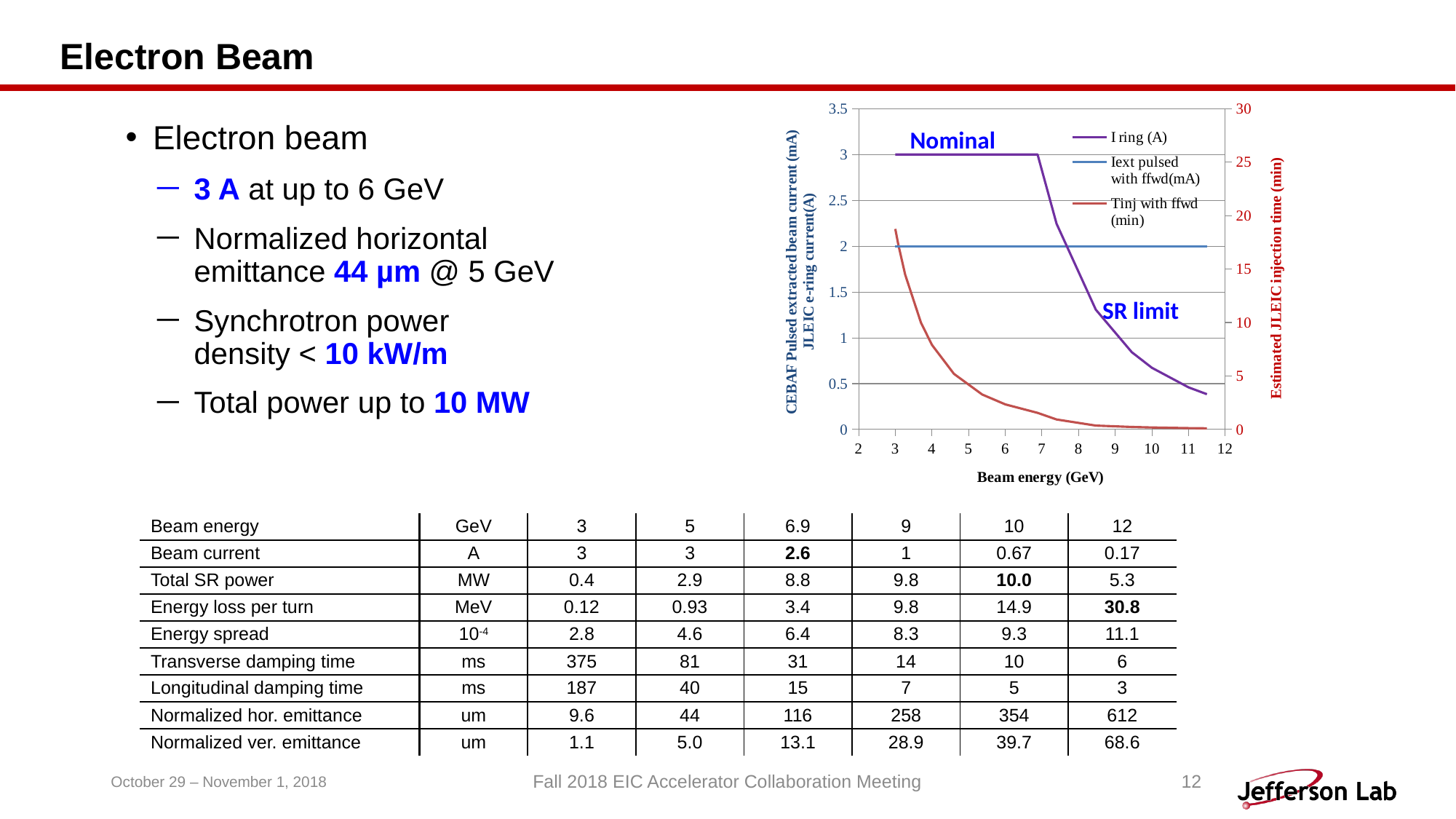
Is the value of the I ring (A) series at 5 GeV greater or less than 2.5? greater How many series does the chart legend list? 3 Which series in the chart is plotted against the right-hand axis, Estimated JLEIC injection time (min)? Tinj with ffwd (min) What kind of chart is shown on the slide? line chart Is the value of the Tinj with ffwd (min) series at 3 GeV greater or less than 15? greater What is the value of the I ring (A) series at a beam energy of 4 GeV? 3 What is the title of the x axis of the chart? Beam energy (GeV) Does the Tinj with ffwd (min) series rise or fall as beam energy increases? fall Is the value of the I ring (A) series at 10 GeV greater or less than 1? less What is the value of the Iext pulsed with ffwd(mA) series across the plotted beam energies? 2 At a beam energy of 10 GeV, which is larger on the left axis: the I ring (A) series or the Iext pulsed with ffwd(mA) series? Iext pulsed with ffwd(mA)